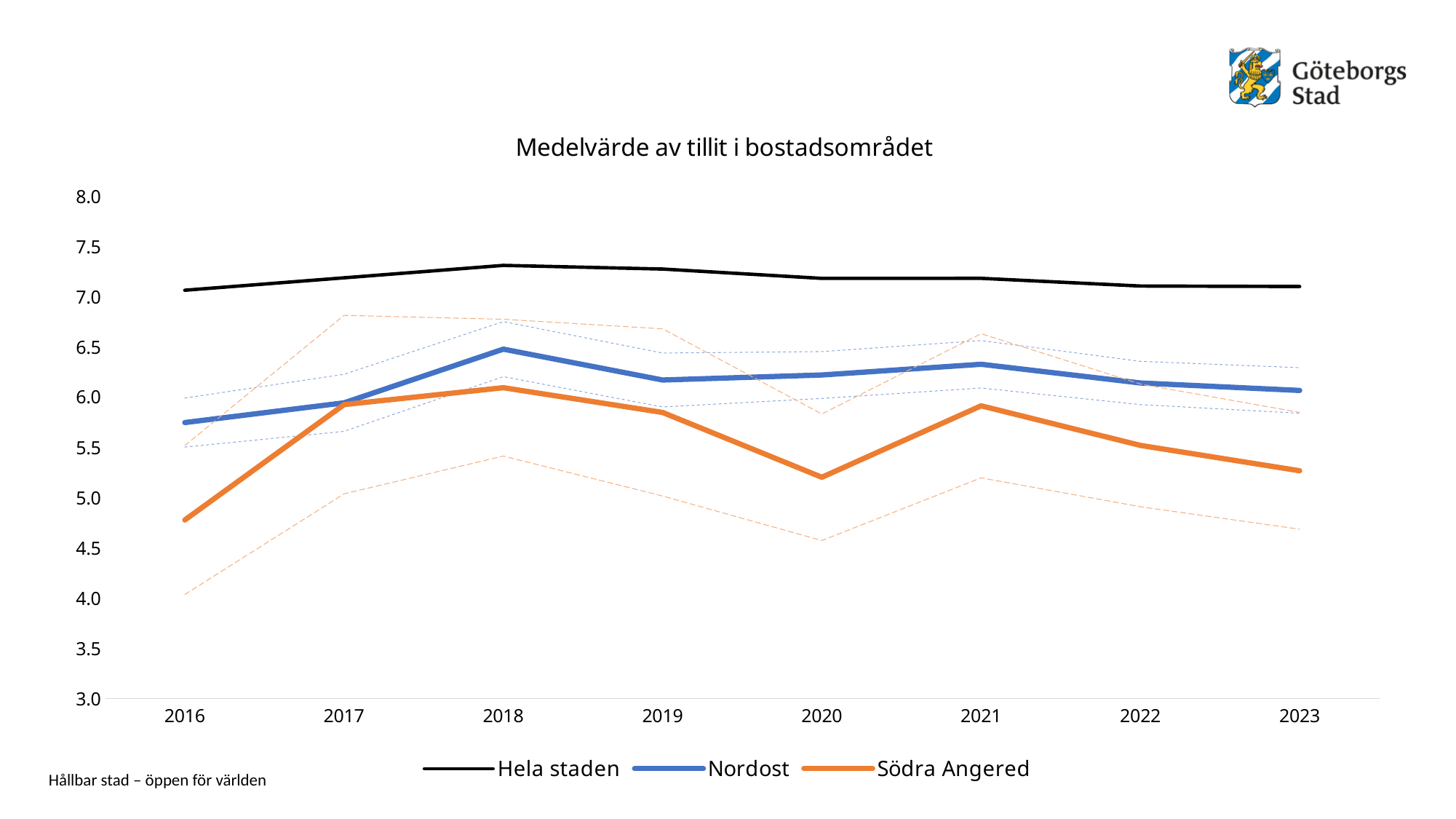
In which year is the Nordost line at its highest? 2018 Is the value for Södra Angered in 2016 greater or less than 5.0? less Is the value for Hela staden in 2016 greater or less than 7.0? greater Which colour is used for the Södra Angered line? orange In 2020, which series has the larger value, Hela staden or Södra Angered? Hela staden In which year is the Södra Angered line at its lowest? 2016 What is the title of the chart? Medelvärde av tillit i bostadsområdet What kind of chart is shown on the slide? line chart Does the Södra Angered line rise or fall from 2021 to 2023? fall Is the value for Nordost in 2018 greater or less than 6.0? greater How many series does the legend list? 3 How many years are shown on the x axis? 8